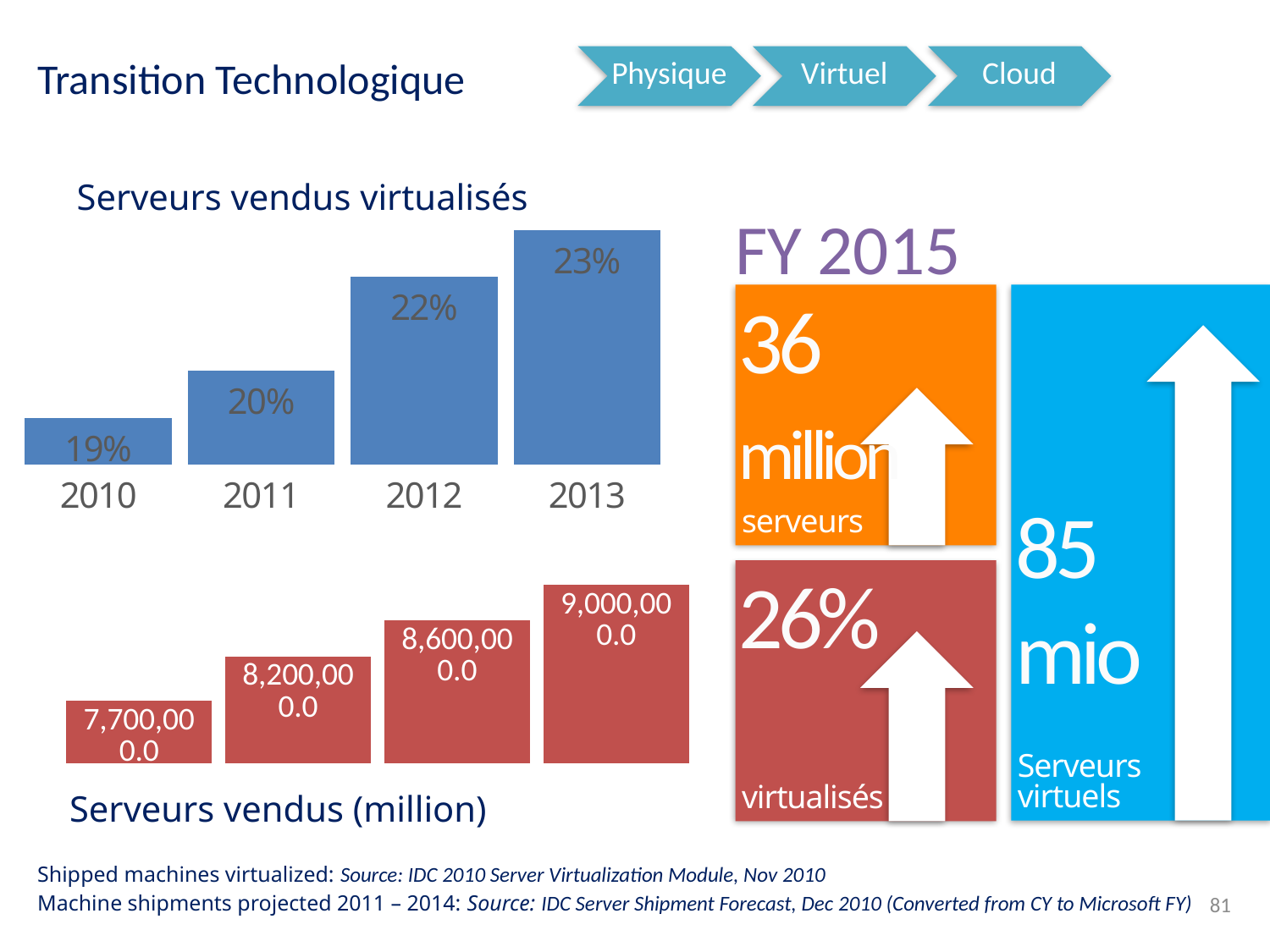
In the 'Serveurs vendus virtualisés' chart, what is the value for 2010? 19% In the 'Serveurs vendus virtualisés' chart, how many years are shown? 4 In the 'Serveurs vendus (million)' chart, what is the value of the first (leftmost) bar? 7,700,000.0 In the 'Serveurs vendus virtualisés' chart, what is the difference between the values for 2013 and 2010? 4% In the 'Serveurs vendus virtualisés' chart, do the values rise or fall from 2010 to 2013? rise In the 'Serveurs vendus (million)' chart, what is the difference between the third bar and the second bar? 400,000.0 In the 'Serveurs vendus virtualisés' chart, which year has the lowest value? 2010 In the 'Serveurs vendus virtualisés' chart, what is the value for 2012? 22% In the 'Serveurs vendus (million)' chart, how many bars are shown? 4 In the 'Serveurs vendus virtualisés' chart, which year has the highest value? 2013 In the 'Serveurs vendus (million)' chart, what is the value of the last (rightmost) bar? 9,000,000.0 What kind of chart is the 'Serveurs vendus (million)' chart? bar chart